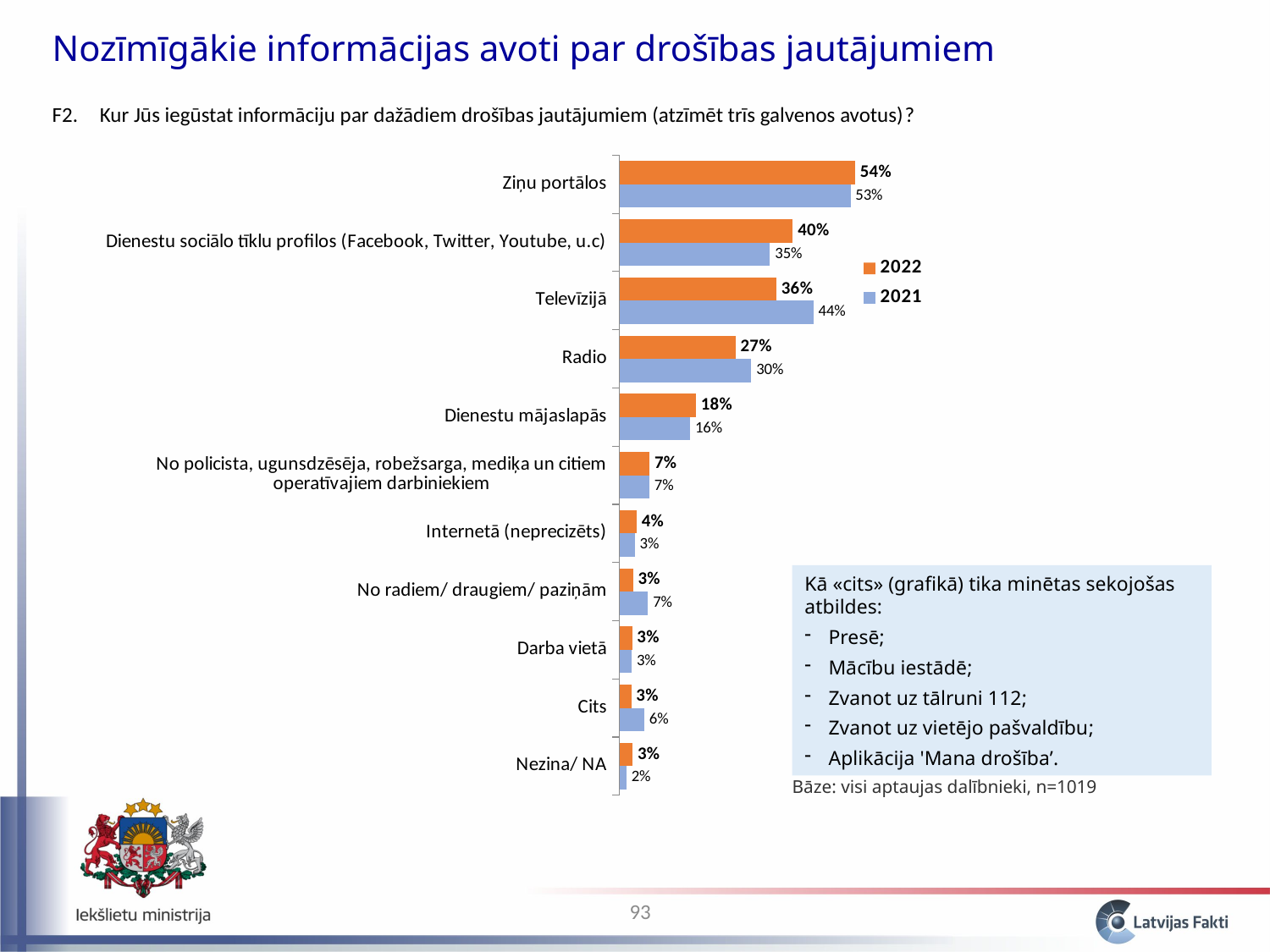
Which category has the highest 2022 value? Ziņu portālos What is the 2021 value for Dienestu sociālo tīklu profilos (Facebook, Twitter, Youtube, u.c)? 35% Which category has the lowest 2021 value? Nezina/ NA Which series is shown in orange in the legend? 2022 How many categories are shown in the chart? 11 How many series does the legend list? 2 What is the 2022 value for Ziņu portālos? 54% What is the 2021 value for Televīzijā? 44% What is the difference between the 2021 and 2022 values for Televīzijā? 8% Which is larger for Radio: the 2022 value or the 2021 value? 2021 What is the difference between the 2022 and 2021 values for Cits? 3% What kind of chart is shown on the slide? Bar chart